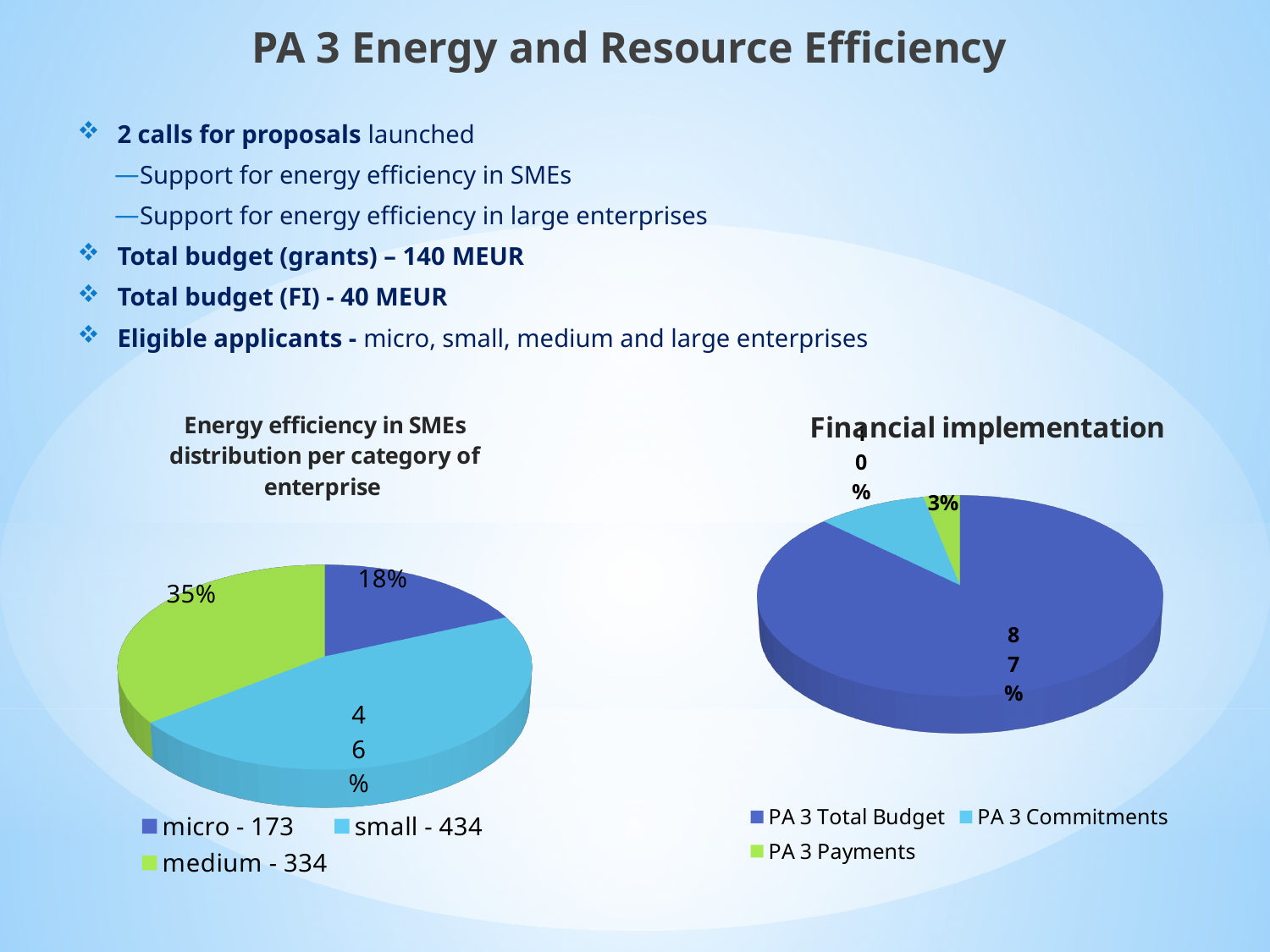
In the 'Energy efficiency in SMEs distribution per category of enterprise' chart, how many categories are shown? 3 In the 'Energy efficiency in SMEs distribution per category of enterprise' chart, which category has the largest slice? small - 434 In the 'Financial implementation' chart, what share of the pie is PA 3 Total Budget? 87% In the 'Financial implementation' chart, what is the difference in percentage points between PA 3 Commitments and PA 3 Payments? 7 percentage points What kind of chart is the 'Energy efficiency in SMEs distribution per category of enterprise' chart? Pie chart In the 'Financial implementation' chart, what share of the pie is PA 3 Payments? 3% In the 'Energy efficiency in SMEs distribution per category of enterprise' chart, what share of the pie is the small enterprise slice? 46% In the 'Financial implementation' chart, which slice is the largest? PA 3 Total Budget In the 'Energy efficiency in SMEs distribution per category of enterprise' chart, which category has the smallest slice? micro - 173 In the 'Financial implementation' chart, how many entries does the legend list? 3